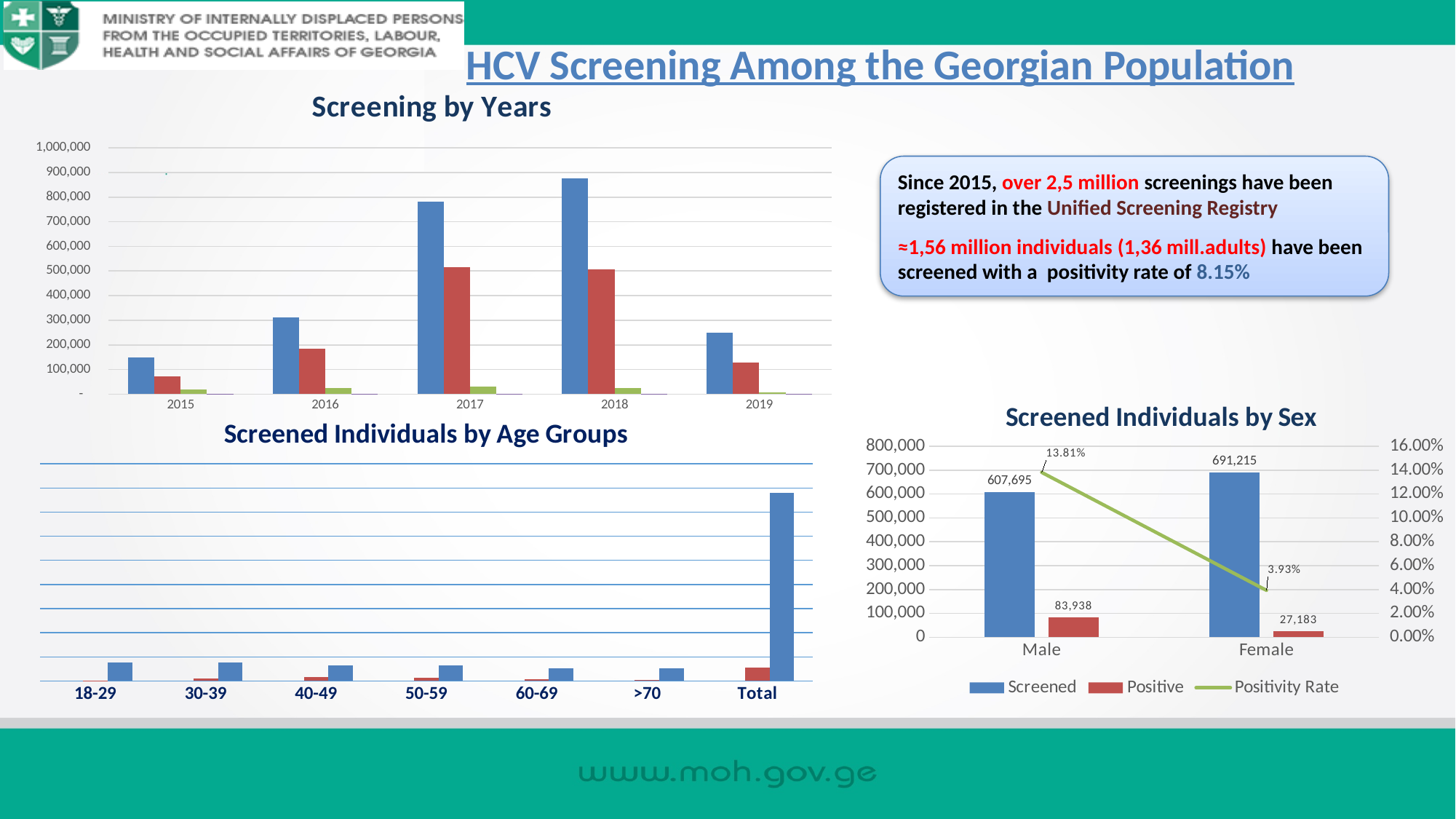
In the 'Screened Individuals by Sex' chart, what is the positivity rate for males? 13.81% In the 'Screened Individuals by Sex' chart, what is the Positive value for females? 27,183 In the 'Screened Individuals by Sex' chart, what is the difference between the Positive values for males and females? 56,755 In the 'Screened Individuals by Sex' chart, which sex has the higher positivity rate? Male In the 'Screened Individuals by Sex' chart, how many individuals were screened among males? 607,695 In the 'Screening by Years' chart, how many years are shown on the x axis? 5 In the 'Screening by Years' chart, is the blue bar for 2017 greater or less than 700,000? greater In the 'Screening by Years' chart, which year has the tallest blue bar? 2018 In the 'Screened Individuals by Sex' chart, how many series does the legend list? 3 In the 'Screened Individuals by Age Groups' chart, how many categories are shown on the x axis? 7 In the 'Screened Individuals by Sex' chart, how many more females than males were screened? 83,520 In the 'Screening by Years' chart, is the blue bar for 2019 greater or less than 300,000? less